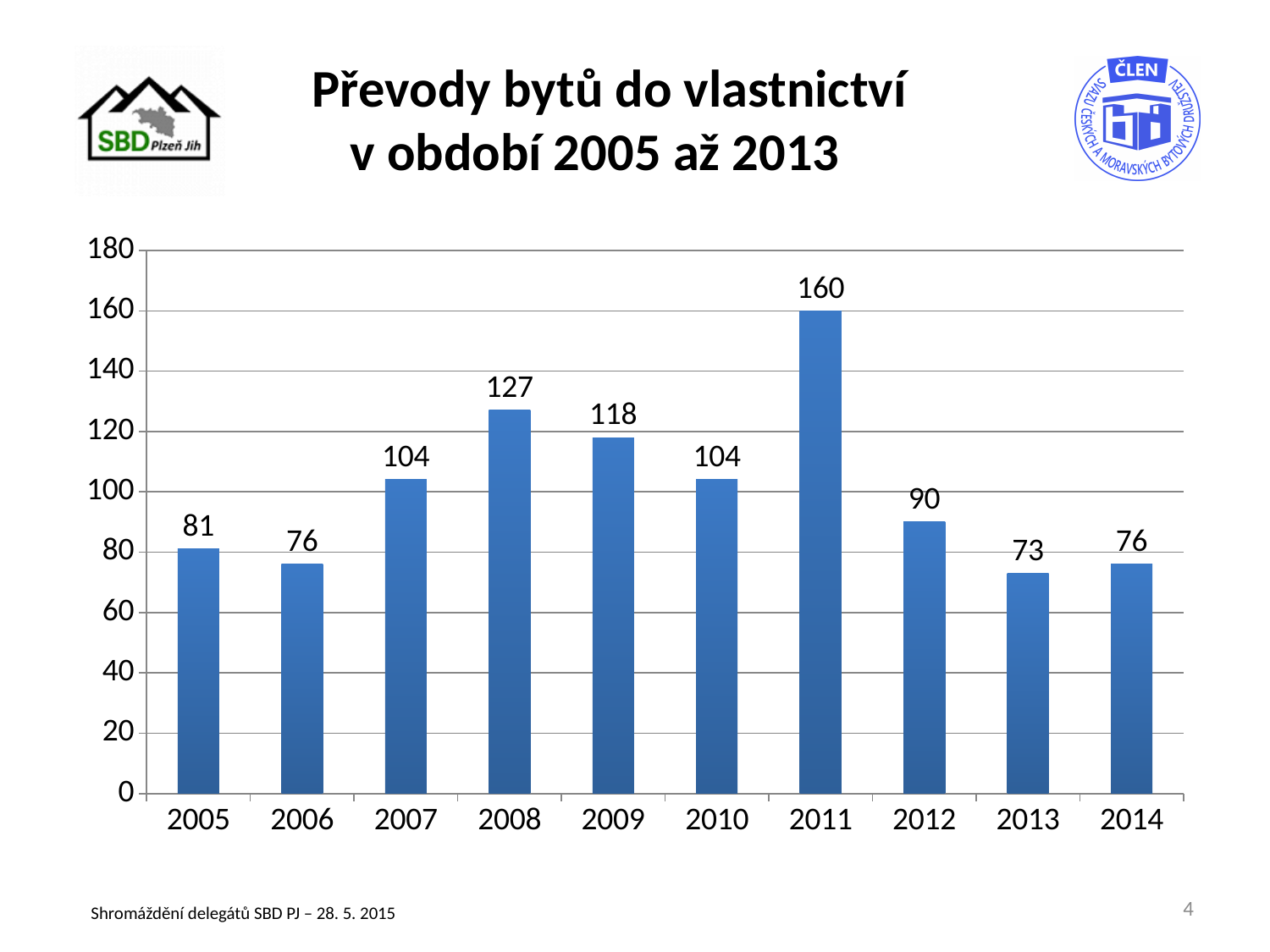
What is the difference between the values for 2008 and 2009? 9 Which year has the lowest value? 2013 Do the values rise or fall from 2011 to 2013? fall What is the value for 2013? 73 Which year has the highest value? 2011 What kind of chart is shown on the slide? bar chart What is the value for 2011? 160 How many years are shown on the x axis? 10 Which is larger, the value for 2005 or the value for 2012? 2012 What is the difference between the values for 2011 and 2012? 70 What is the value for 2008? 127 Is the value for 2009 greater or less than 100? greater